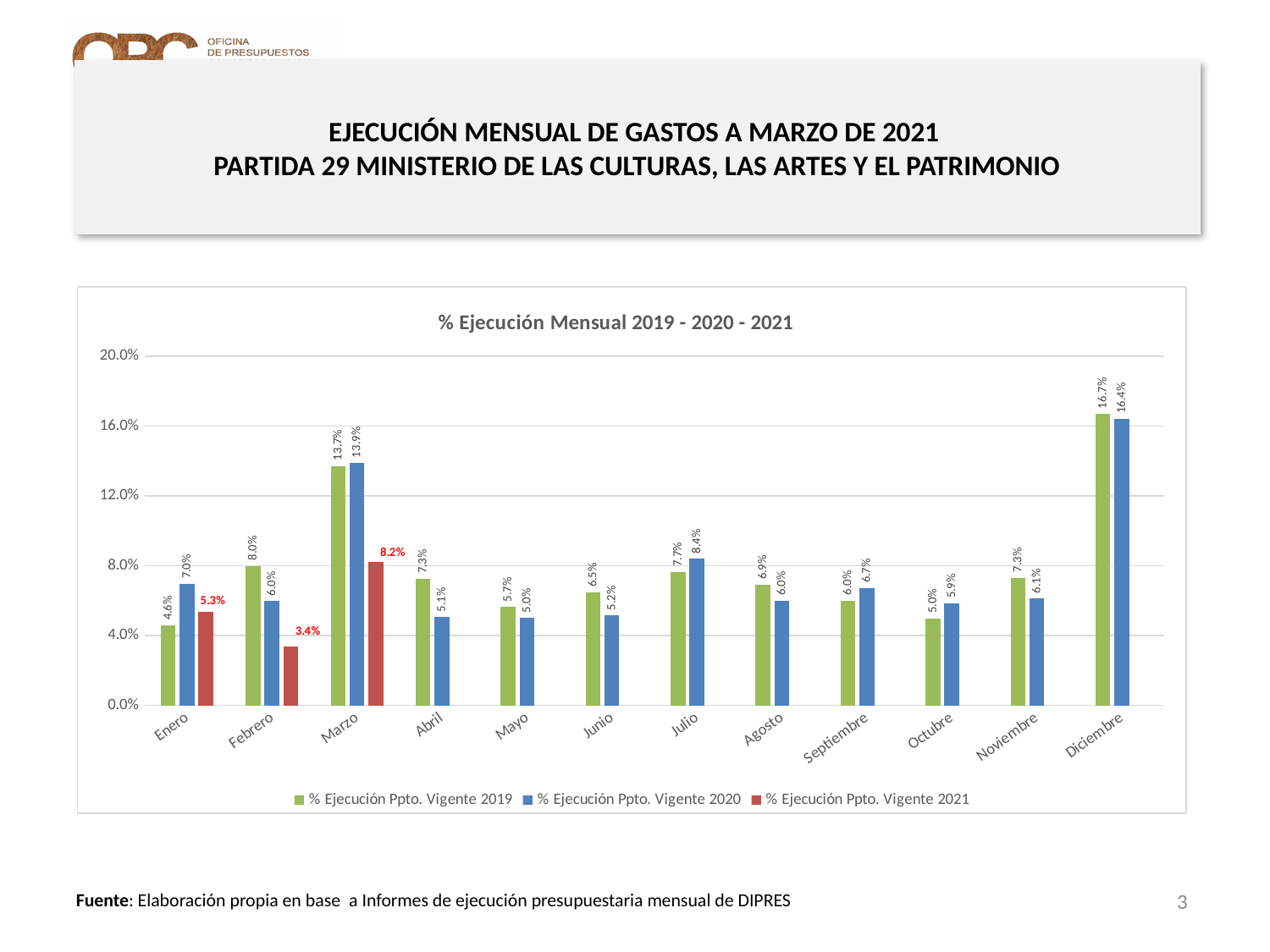
Which month has the lowest value in the % Ejecución Ppto. Vigente 2021 series? Febrero How many series does the legend list? 3 What is the title of the chart? % Ejecución Mensual 2019 - 2020 - 2021 What is the value for Julio in the % Ejecución Ppto. Vigente 2020 series? 8.4% Which month has the highest value in the % Ejecución Ppto. Vigente 2020 series? Diciembre What is the value for Diciembre in the % Ejecución Ppto. Vigente 2019 series? 16.7% What is the value for Marzo in the % Ejecución Ppto. Vigente 2021 series? 8.2% Which is larger for Enero: the % Ejecución Ppto. Vigente 2019 value or the % Ejecución Ppto. Vigente 2020 value? % Ejecución Ppto. Vigente 2020 How many months are shown on the x axis? 12 What is the difference between the 2019 and 2021 values for Marzo? 5.5% Is the value for Diciembre in the 2019 series greater or less than 12.0%? greater What kind of chart is shown on the slide? Bar chart